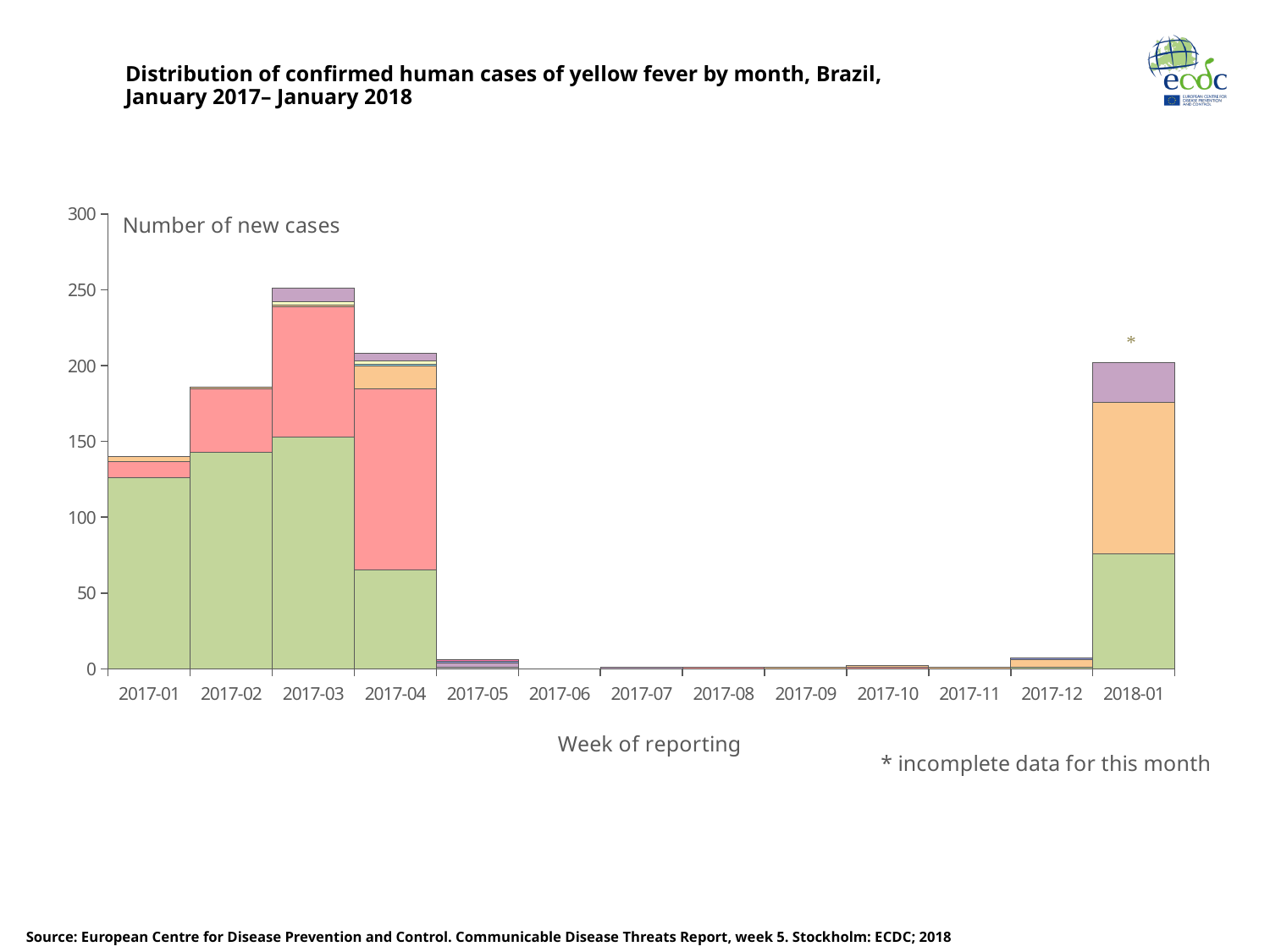
Which month has more new cases in total, 2017-01 or 2018-01? 2018-01 Which month has the highest total number of new cases? 2017-03 Is the total number of new cases for 2017-01 greater or less than 150? less Is the total number of new cases for 2017-02 greater or less than 150? greater Is the total number of new cases for 2018-01 greater or less than 150? greater Do the total number of new cases rise or fall from 2017-03 to 2017-06? fall Which month is marked with an asterisk indicating incomplete data? 2018-01 What is the label of the x axis of the chart? Week of reporting How many months are shown along the x axis of the chart? 13 What kind of chart is shown on the slide? stacked bar chart